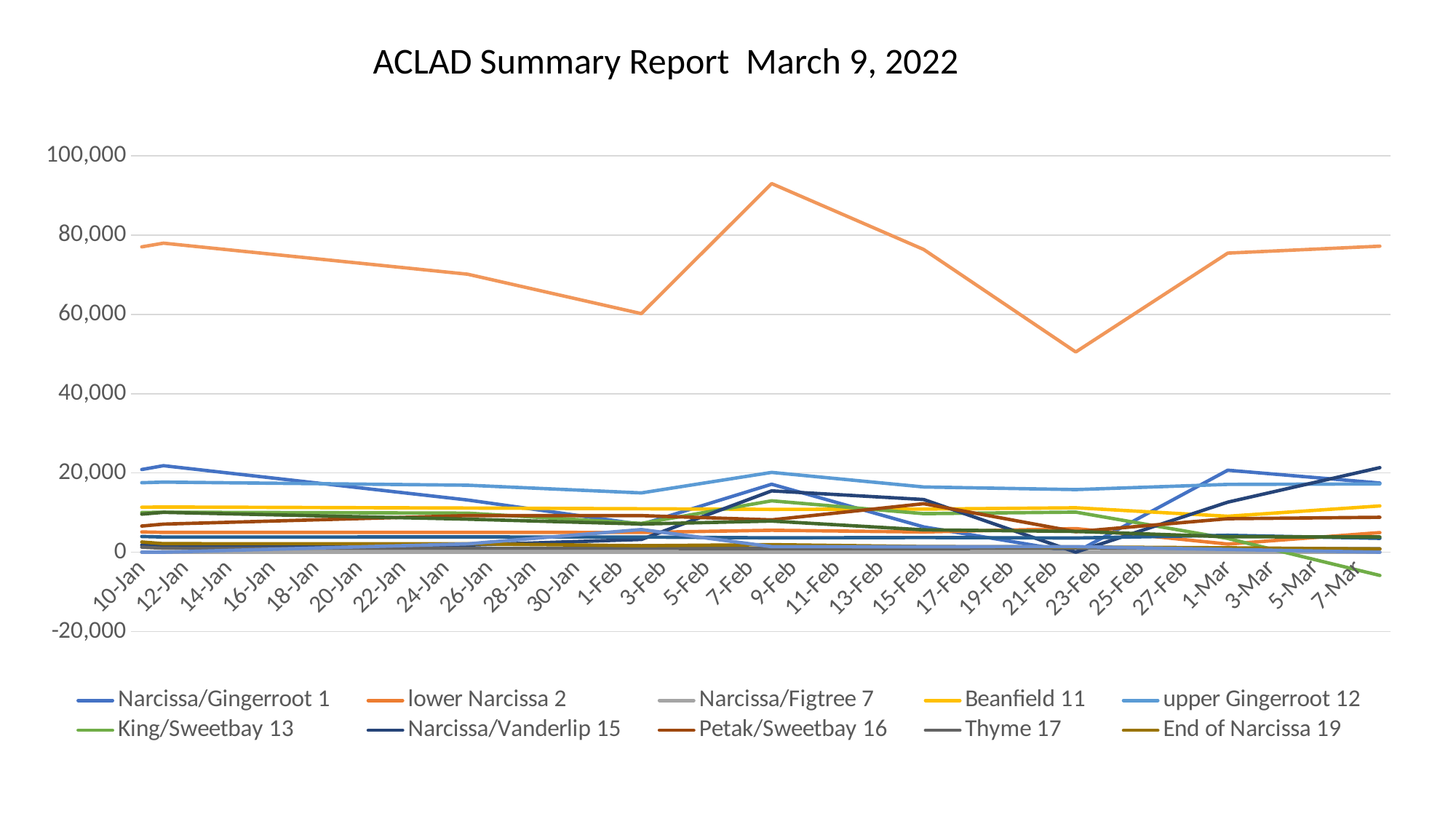
Is the value for lower Narcissa 2 on 9-Feb greater or less than 80,000? greater What kind of chart is shown on the slide? line chart Which series has the highest values across the whole chart? lower Narcissa 2 How many dates are shown along the x axis? 29 What is the title of the chart? ACLAD Summary Report March 9, 2022 Is the value for upper Gingerroot 12 on 10-Jan greater or less than 20,000? less Does lower Narcissa 2 rise or fall between 9-Feb and 23-Feb? fall How many series does the legend list? 10 Is the value for lower Narcissa 2 on 23-Feb greater or less than 60,000? less